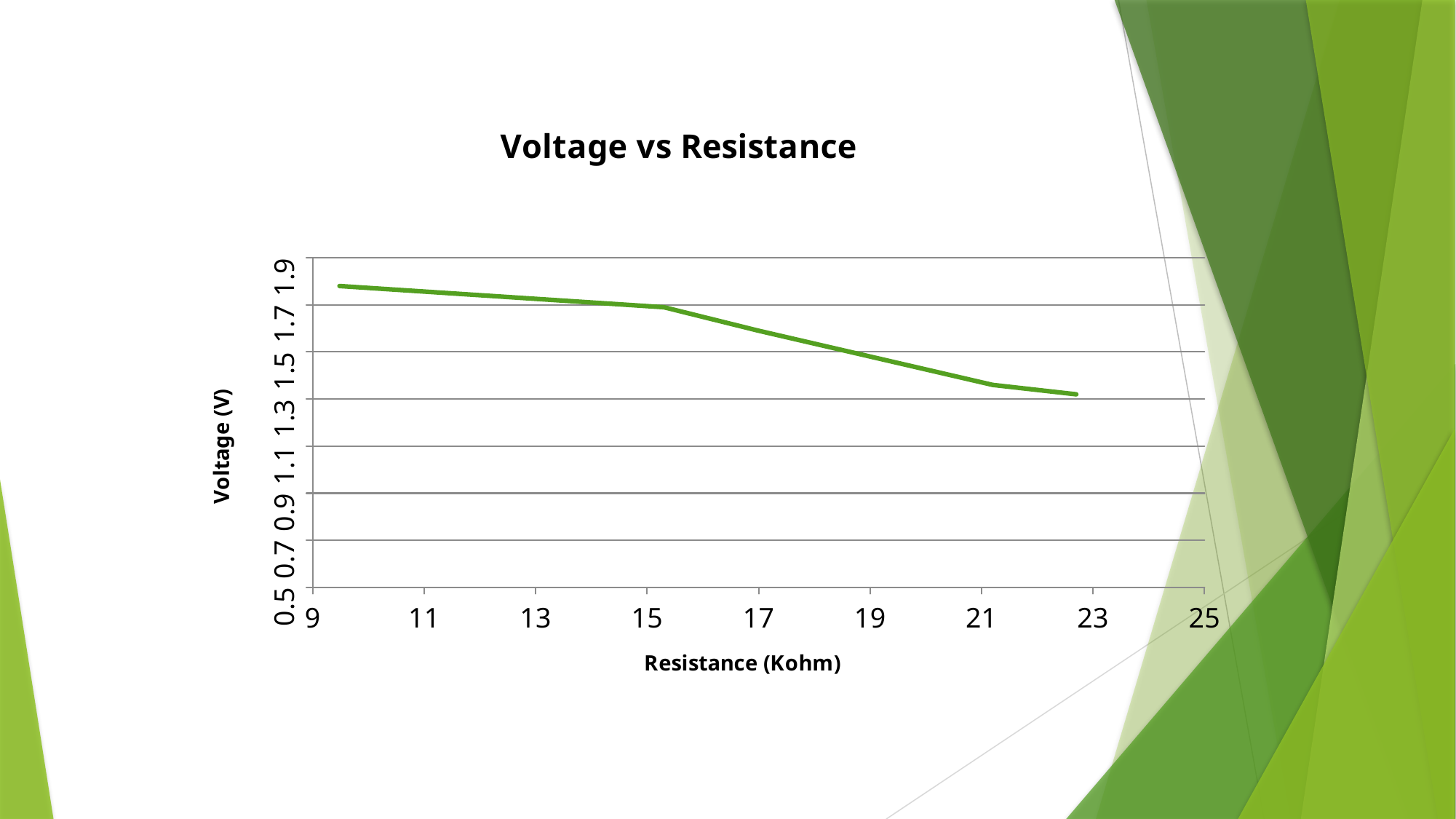
Is the voltage at a resistance of 21 Kohm greater or less than 1.5? less At which end of the resistance range is the voltage highest, the low end or the high end? the low end Is the voltage at a resistance of 13 Kohm greater or less than 1.9? less Is the voltage at the leftmost point of the line greater or less than 1.7? greater Does the voltage rise or fall as resistance increases along the x axis? fall What is the title of the chart? Voltage vs Resistance Which has the higher voltage: a resistance of 11 Kohm or 21 Kohm? 11 Kohm What kind of chart is shown on the slide? line chart What is the label of the x axis of the chart? Resistance (Kohm)